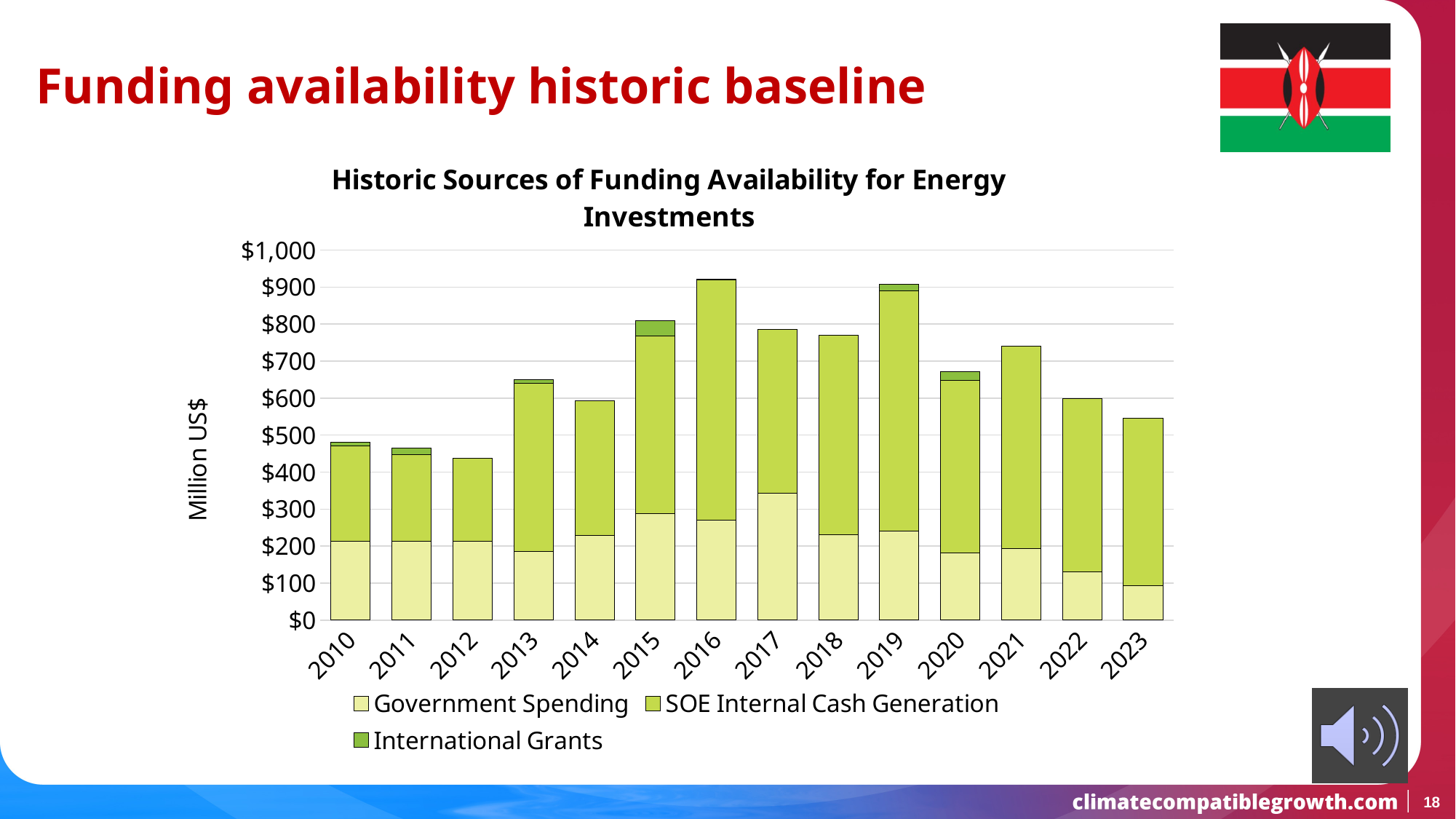
What is the label of the y axis? Million US$ How many series does the legend list? 3 Is the total funding for 2023 greater or less than $600 million? less Is Government Spending in 2017 greater or less than $300 million? greater Which year has the larger total funding, 2013 or 2014? 2013 Is the total funding for 2016 greater or less than $900 million? greater Which year has the lowest Government Spending? 2023 Do total funding values rise or fall from 2019 to 2023? fall What kind of chart is shown on the slide? Stacked bar chart Which year has the highest Government Spending? 2017 Which year has the lowest total funding availability? 2012 How many years are shown on the x axis? 14